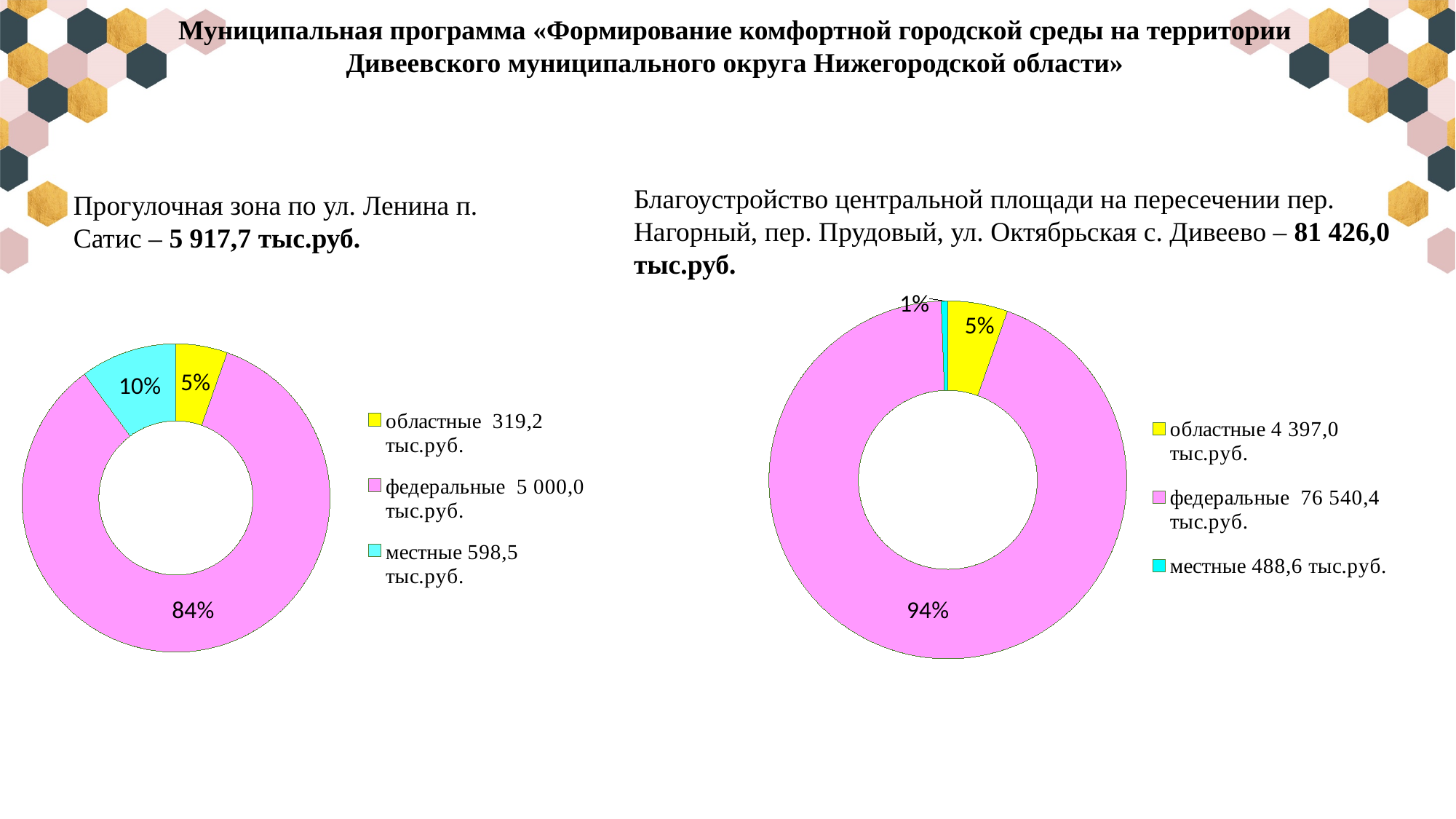
In the right chart (Благоустройство центральной площади с. Дивеево), which is larger: the областные share or the местные share? областные In the right chart (Благоустройство центральной площади с. Дивеево), what is the amount of областные funds shown in the legend? 4 397,0 тыс.руб. In the left chart (Прогулочная зона по ул. Ленина п. Сатис), how many slices does the chart have? 3 In the right chart (Благоустройство центральной площади с. Дивеево), what share of the total do федеральные funds make up? 94% In the left chart (Прогулочная зона по ул. Ленина п. Сатис), which funding source has the smallest share? областные In the right chart (Благоустройство центральной площади с. Дивеево), which funding source has the largest share? федеральные In the right chart (Благоустройство центральной площади с. Дивеево), what is the amount of местные funds shown in the legend? 488,6 тыс.руб. In the left chart (Прогулочная зона по ул. Ленина п. Сатис), what share of the total do федеральные funds make up? 84% In the left chart (Прогулочная зона по ул. Ленина п. Сатис), what is the amount of местные funds shown in the legend? 598,5 тыс.руб. In the left chart (Прогулочная зона по ул. Ленина п. Сатис), what is the difference in percentage points between the местные and областные shares? 5 percentage points In the right chart (Благоустройство центральной площади с. Дивеево), what colour is the slice for федеральные funds? Pink What kind of chart is the left chart (Прогулочная зона по ул. Ленина п. Сатис)? Doughnut (pie) chart